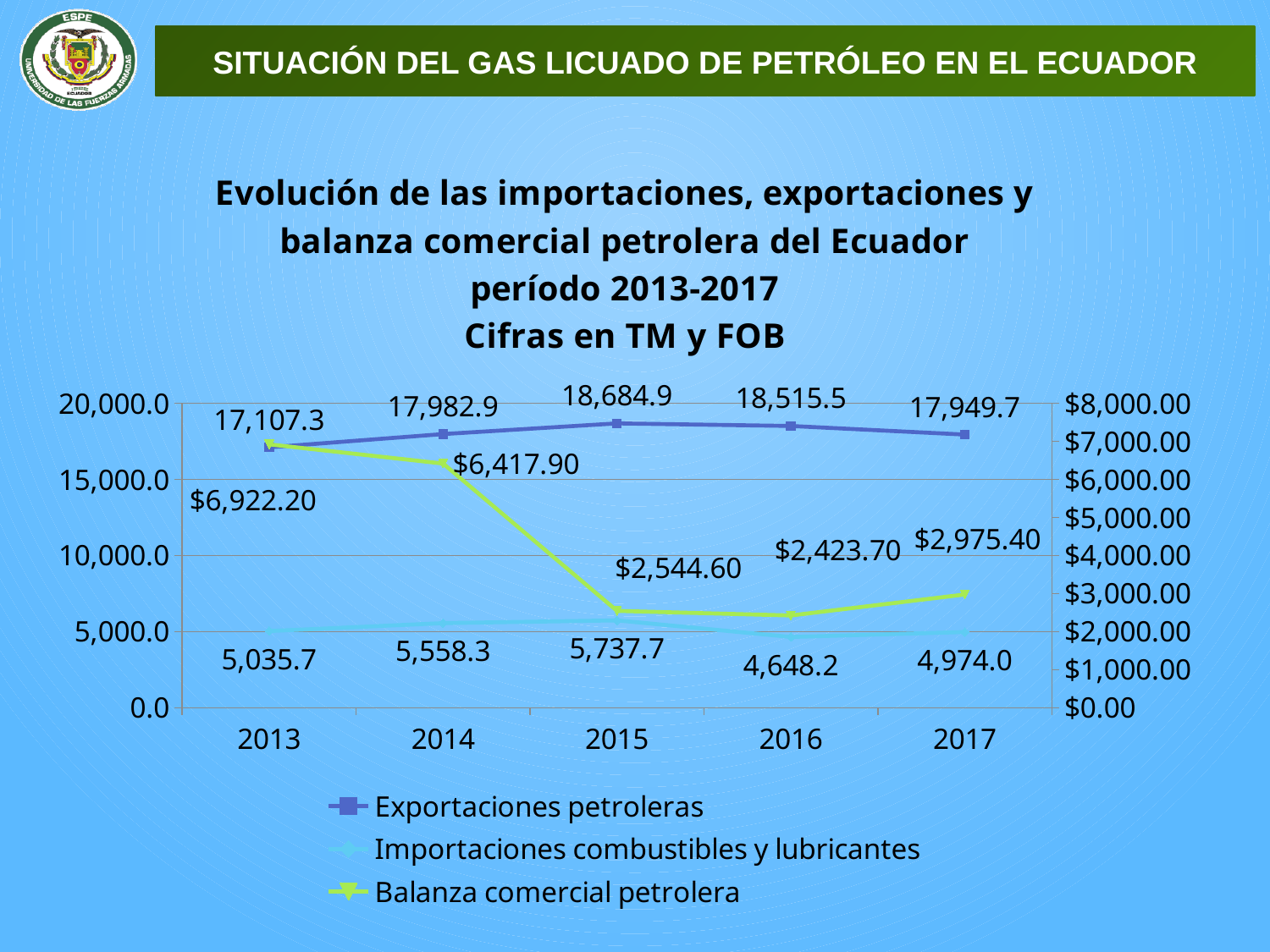
What kind of chart is shown on the slide? Line chart Does Balanza comercial petrolera rise or fall from 2013 to 2016? Fall How many series does the legend list? 3 How many years are plotted on the x axis? 5 In which year is Balanza comercial petrolera lowest? 2016 Which is larger, Importaciones combustibles y lubricantes in 2014 or in 2017? 2014 What is the value of Importaciones combustibles y lubricantes in 2016? 4,648.2 In which year is Exportaciones petroleras highest? 2015 What is the value of Exportaciones petroleras in 2015? 18,684.9 What is the value of Balanza comercial petrolera in 2013? $6,922.20 What is the difference between Exportaciones petroleras in 2015 and in 2013? 1,577.6 Which series is drawn in green? Balanza comercial petrolera